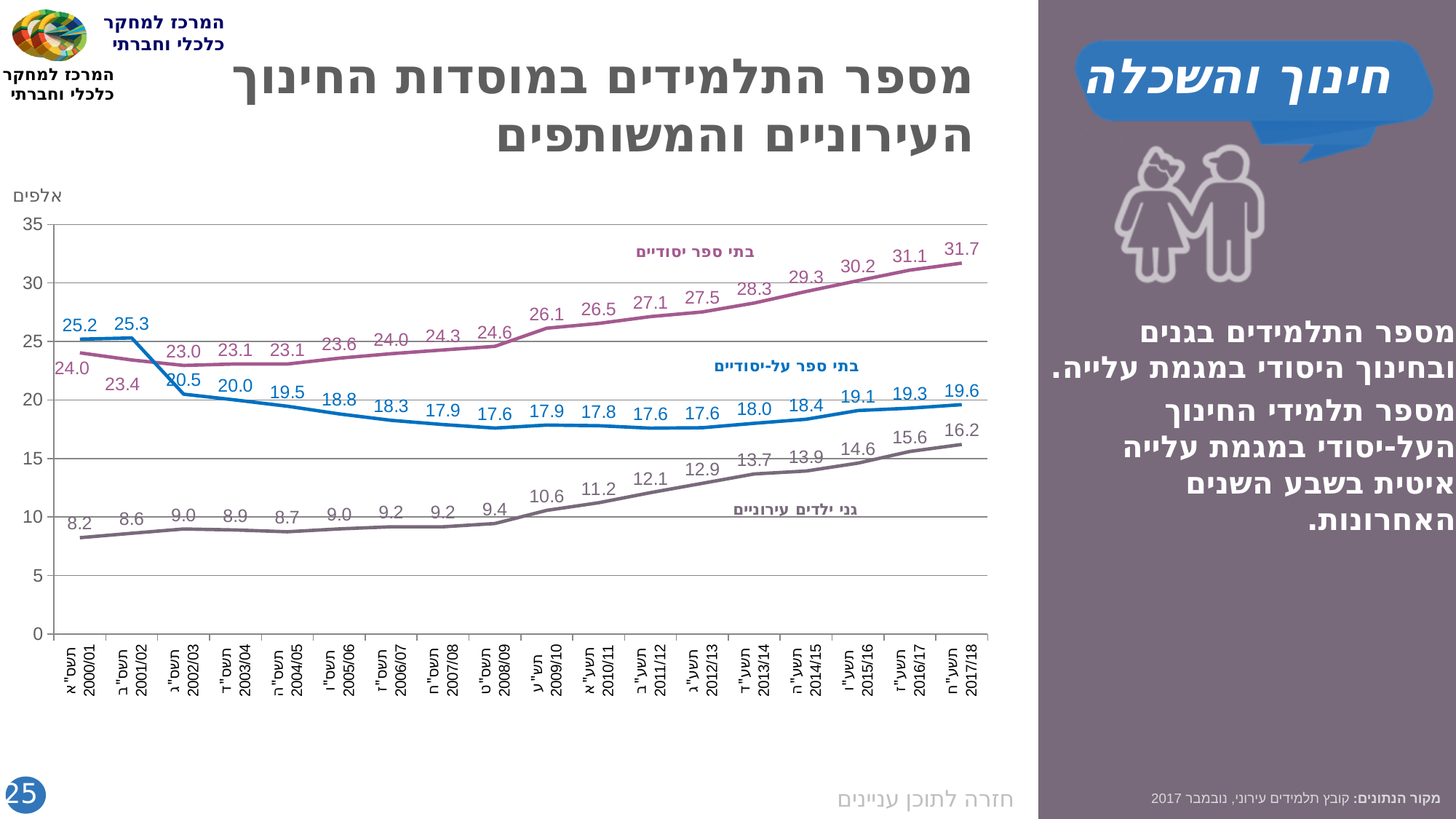
What type of chart is shown on the slide? line chart What unit label is shown above the y axis of the chart? אלפים In which school year is the value for בתי ספר על-יסודיים lowest? 2008/09 (also 2011/12 and 2012/13, all 17.6) How many data series are plotted in the chart? 3 In which school year is the value for גני ילדים עירוניים highest? 2017/18 Does the value for גני ילדים עירוניים rise or fall from 2008/09 to 2017/18? rise What is the value for בתי ספר יסודיים in 2017/18? 31.7 Which series has the larger value in 2000/01, בתי ספר יסודיים or בתי ספר על-יסודיים? בתי ספר על-יסודיים What is the difference between the בתי ספר יסודיים value in 2017/18 and in 2000/01? 7.7 What is the value for גני ילדים עירוניים in 2009/10? 10.6 How many school years are shown along the x axis? 18 What is the value for בתי ספר על-יסודיים in 2000/01? 25.2